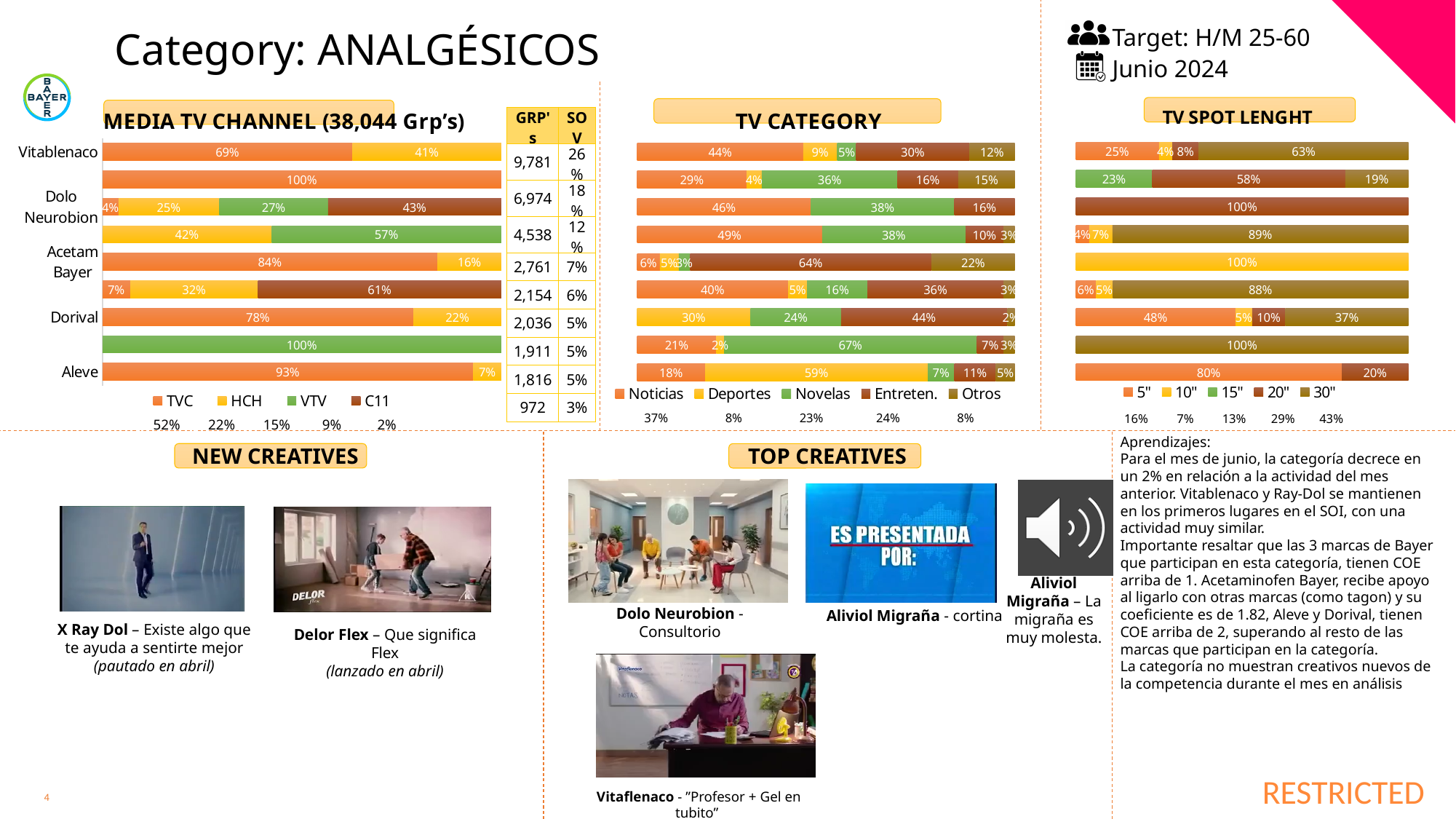
How many series does the legend of the TV CATEGORY chart list? 5 In the TV SPOT LENGHT chart, what is the 30" value in the top bar? 63% How many series does the legend of the TV SPOT LENGHT chart list? 5 What kind of chart is the MEDIA TV CHANNEL chart? bar chart In the MEDIA TV CHANNEL chart, what is the HCH value for Vitablenaco? 41% What total GRP's figure is shown in the title of the MEDIA TV CHANNEL chart? 38,044 In the TV CATEGORY chart, what is the Noticias value in the top bar? 44% How many bars are plotted in the TV CATEGORY chart? 9 How many series does the legend of the MEDIA TV CHANNEL chart list? 4 In the MEDIA TV CHANNEL chart, what is the difference between the TVC and HCH values for Vitablenaco? 28 percentage points In the MEDIA TV CHANNEL chart, what is the TVC value for Vitablenaco? 69% In the top bar of the TV SPOT LENGHT chart, which is larger, the 5" segment or the 30" segment? 30"